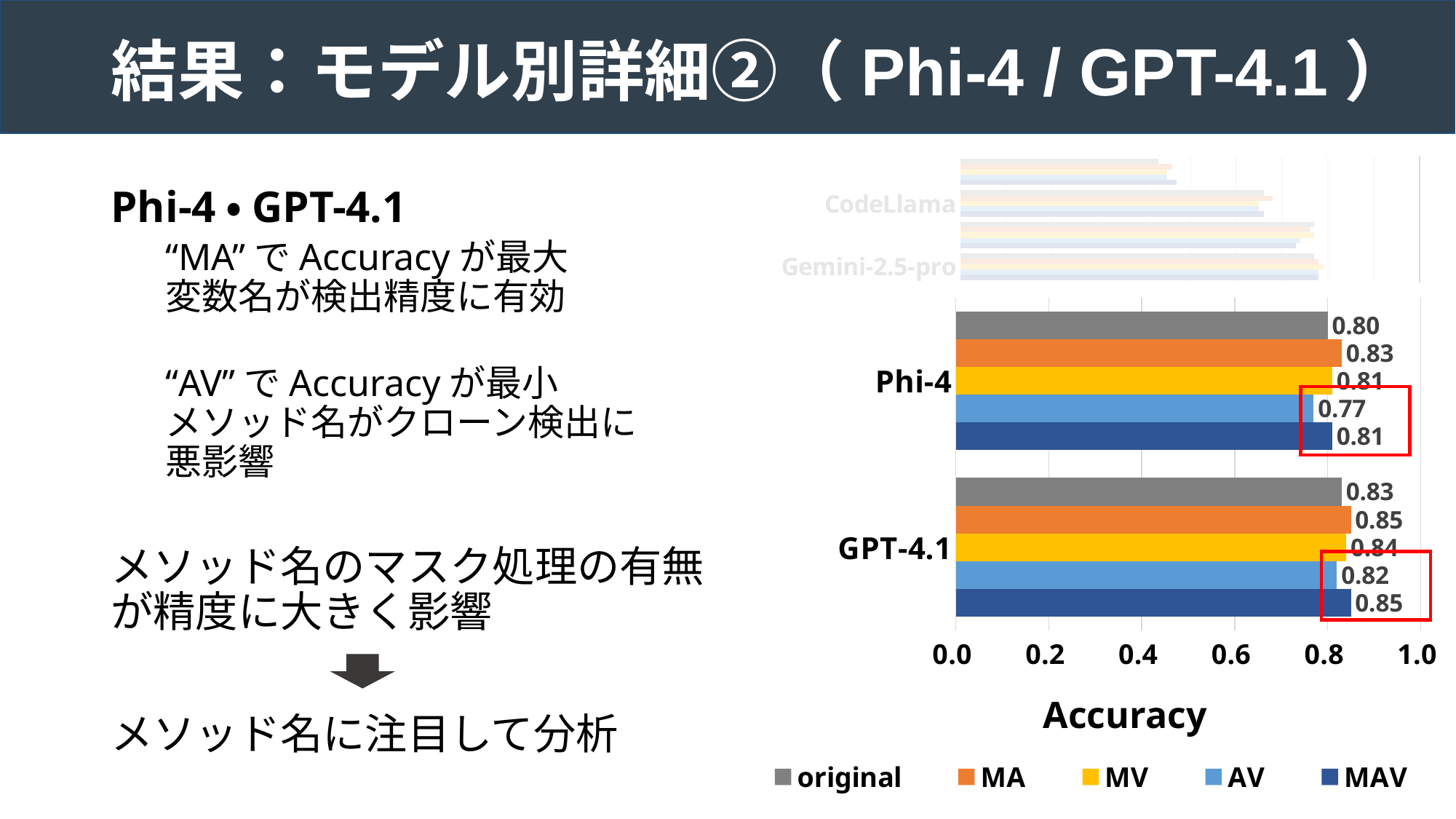
What kind of chart is shown on the slide? Bar chart Which series has the lowest Accuracy for Phi-4? AV How many series does the legend list? 5 What is the Accuracy value for the MAV series for Phi-4? 0.81 What is the Accuracy value for the MA series for Phi-4? 0.83 What is the Accuracy value for the original series for GPT-4.1? 0.83 What is the difference between the MAV and AV Accuracy values for GPT-4.1? 0.03 What is the Accuracy value for the AV series for Phi-4? 0.77 Which has the higher original Accuracy, Phi-4 or GPT-4.1? GPT-4.1 Which series has the lowest Accuracy for GPT-4.1? AV What is the Accuracy value for the AV series for GPT-4.1? 0.82 What is the difference between the MA and AV Accuracy values for Phi-4? 0.06